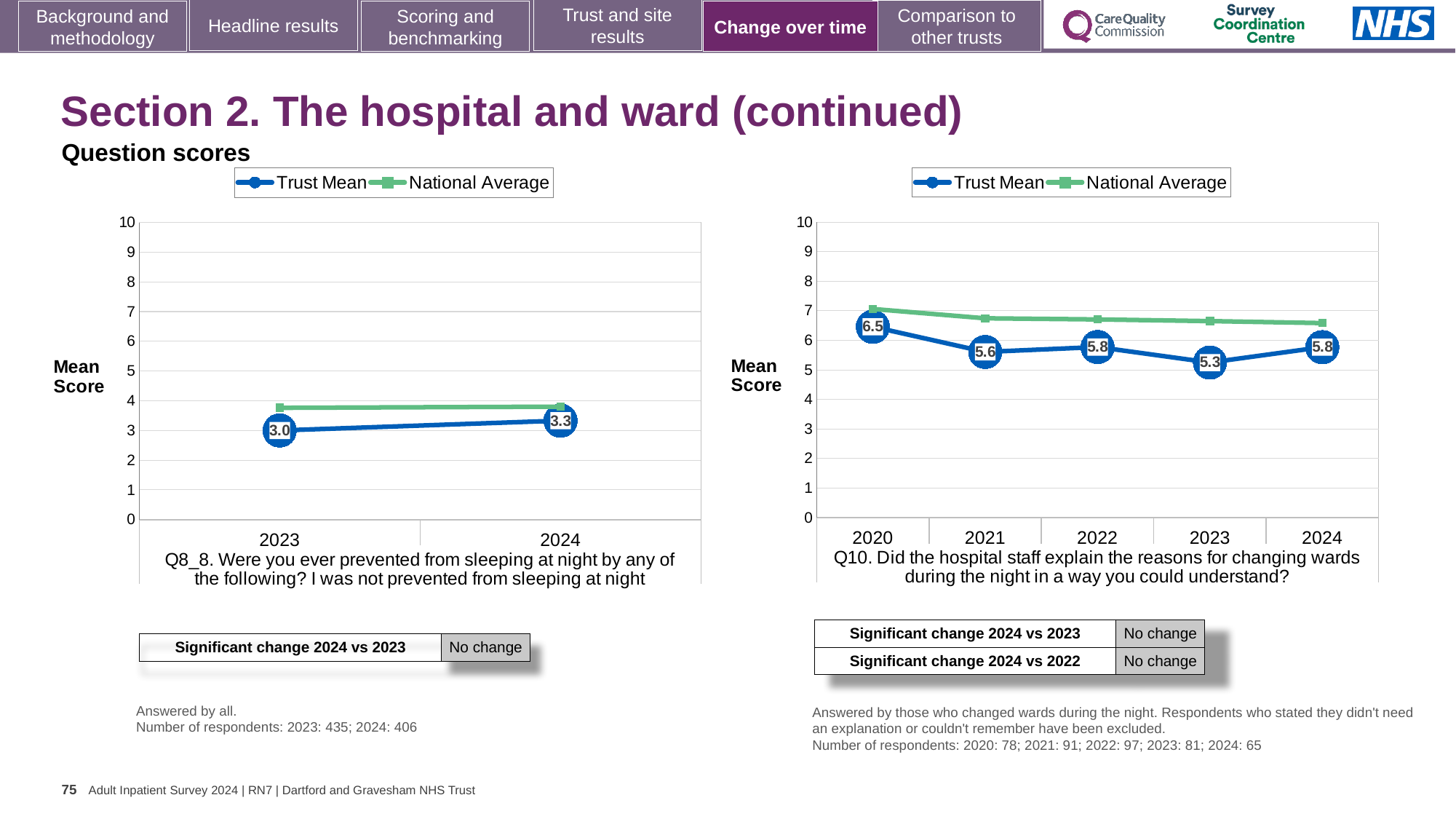
In the left chart (Q8_8), what is the Trust Mean score for 2024? 3.3 In the right chart (Q10), what is the Trust Mean score for 2020? 6.5 In the right chart (Q10), what is the Trust Mean score for 2023? 5.3 In the left chart (Q8_8), is the National Average for 2023 greater or less than 3? greater In the right chart (Q10), what is the difference between the Trust Mean in 2020 and in 2023? 1.2 In the left chart (Q8_8), what is the Trust Mean score for 2023? 3.0 What type of chart is used on the right (Q10)? line chart In the left chart (Q8_8), by how much did the Trust Mean change from 2023 to 2024? 0.3 In the right chart (Q10), how many years are plotted on the x axis? 5 In the left chart (Q8_8), does the Trust Mean rise or fall from 2023 to 2024? rise In the right chart (Q10), which year has the lowest Trust Mean score? 2023 In the right chart (Q10), which year has the highest Trust Mean score? 2020